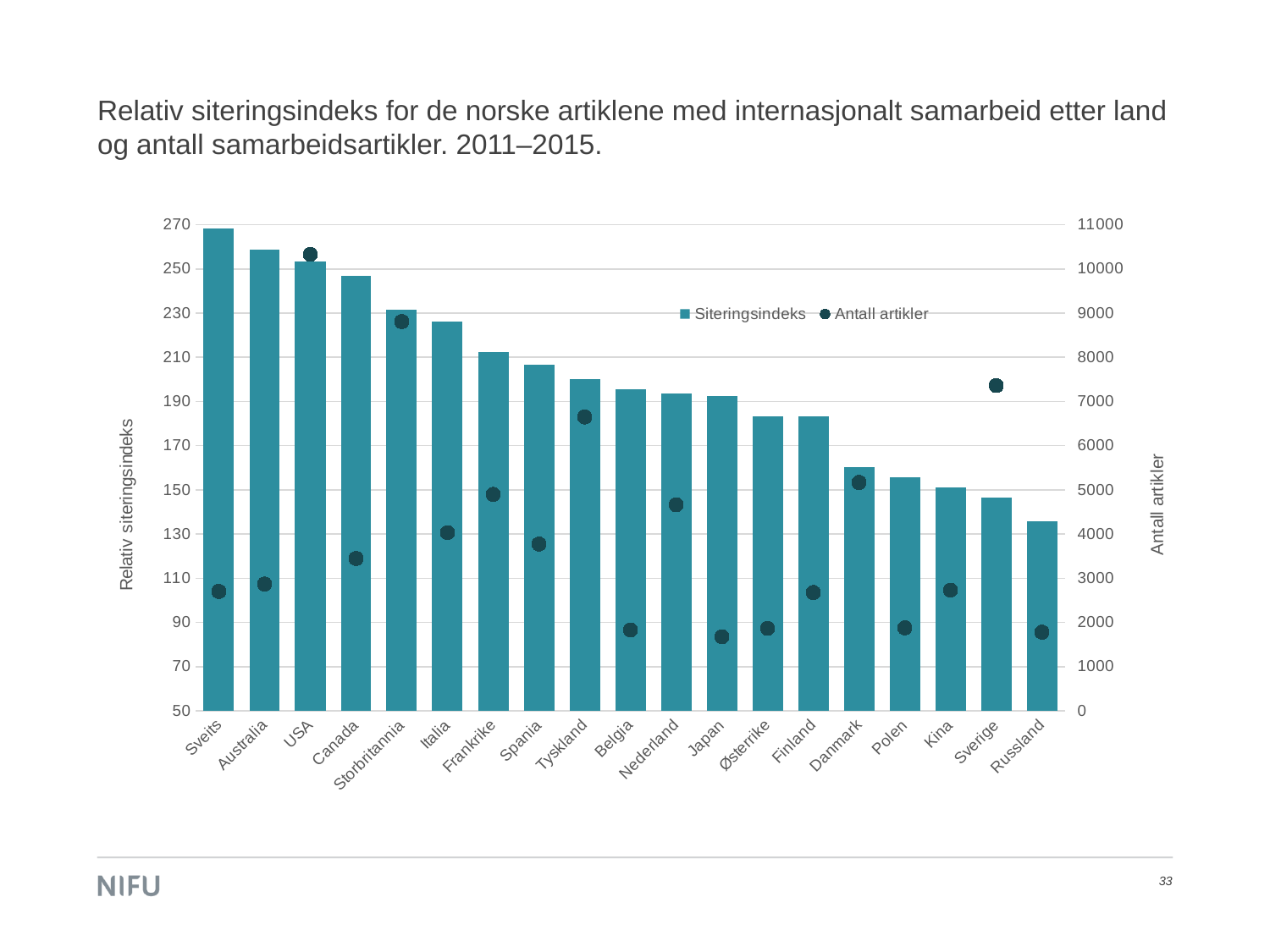
Is the Siteringsindeks value for Russland greater or less than 150? less Is the Siteringsindeks value for Sveits greater or less than 250? greater Which country has the lowest Siteringsindeks bar? Russland Is the Antall artikler value for Sverige greater or less than 7000? greater How many series does the legend list? 2 Do the Siteringsindeks bars rise or fall from left to right along the x axis? fall What kind of chart is used to show the Siteringsindeks series? bar chart How many countries are shown on the x axis? 19 Which country has the highest Antall artikler value? USA Which has the larger Siteringsindeks, Italia or Frankrike? Italia Which country has the highest Siteringsindeks bar? Sveits What is the label of the right-hand vertical axis? Antall artikler